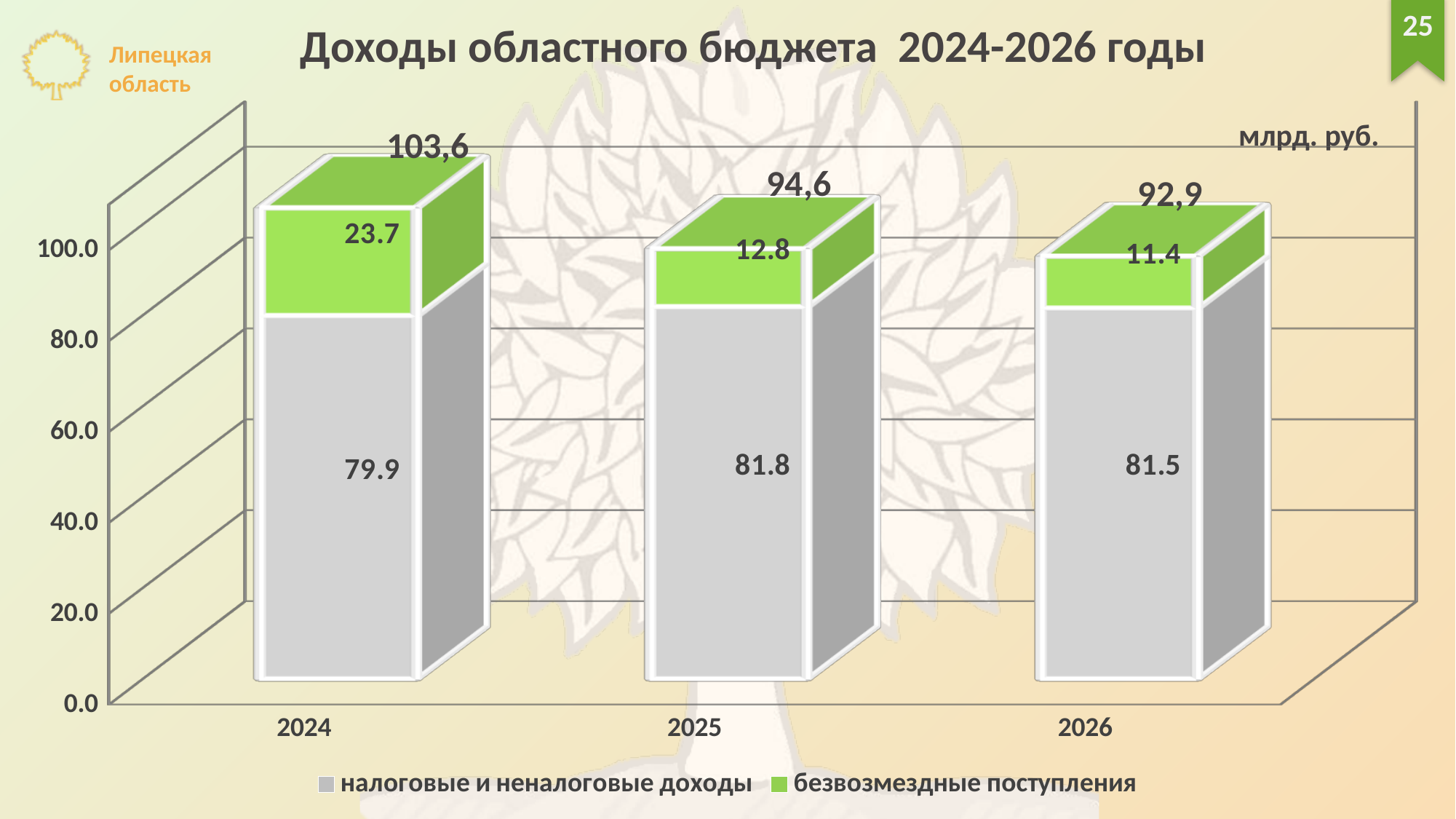
What is the total shown above the bar for 2026? 92,9 How many years are shown on the x axis? 3 What is the value of безвозмездные поступления for 2025? 12.8 Which is larger: налоговые и неналоговые доходы in 2025 or in 2026? 2025 Which year has the lowest value of налоговые и неналоговые доходы? 2024 What is the total shown above the bar for 2024? 103,6 What is the value of налоговые и неналоговые доходы for 2024? 79.9 Do the bar totals rise or fall from 2024 to 2026? fall What kind of chart is shown on the slide? stacked bar chart Which year has the highest value of безвозмездные поступления? 2024 How many series does the legend list? 2 What is the difference between безвозмездные поступления in 2024 and 2025? 10.9